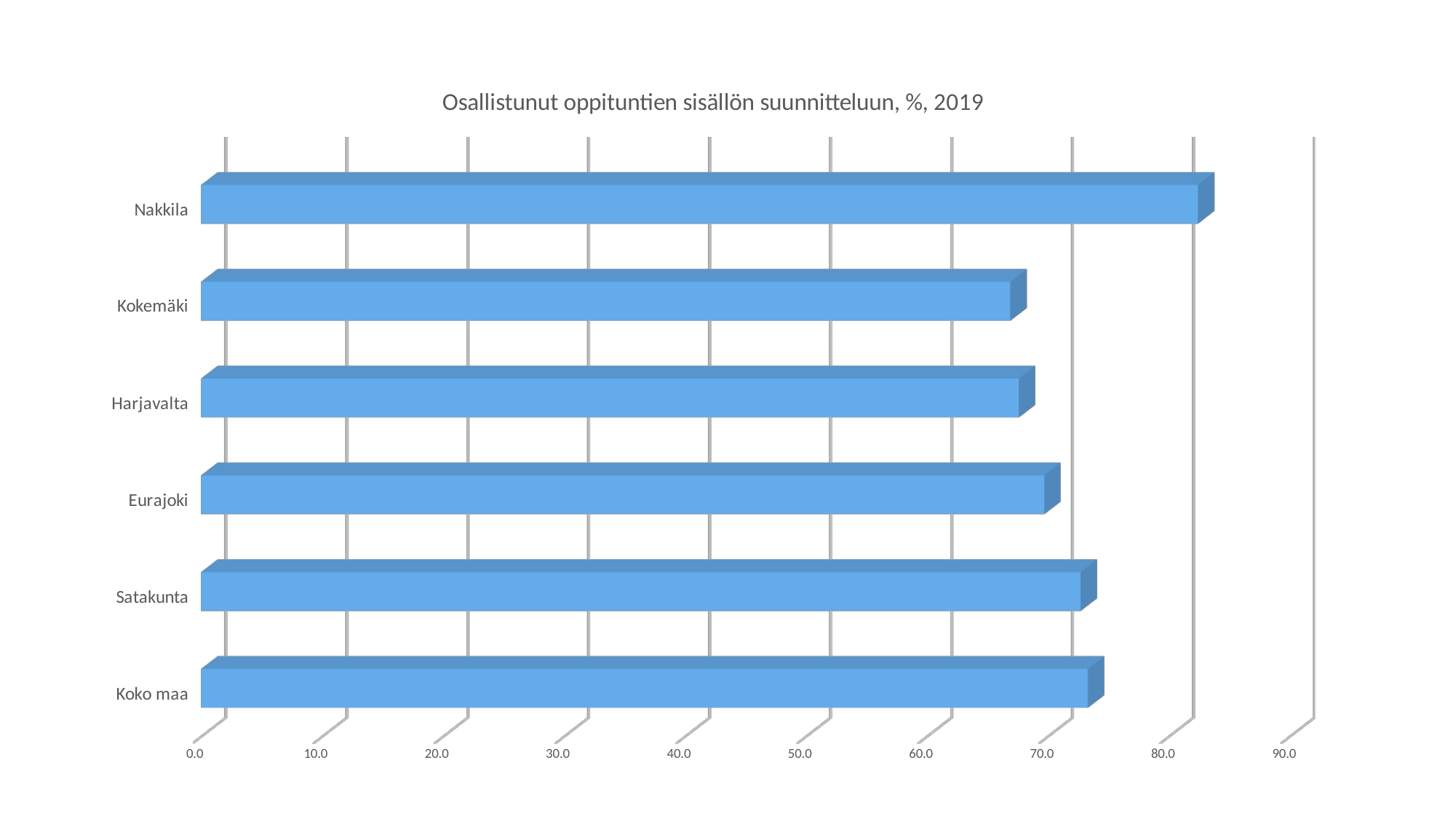
Which category has the highest value? Nakkila What is the title of the chart? Osallistunut oppituntien sisällön suunnitteluun, %, 2019 Is the value for Nakkila greater or less than 80.0? greater How many categories are shown in the chart? 6 Is the value for Harjavalta greater or less than 70.0? less Is the value for Kokemäki greater or less than 70.0? less What kind of chart is shown on the slide? bar chart Which is larger, the value for Nakkila or the value for Kokemäki? Nakkila What is the highest value shown on the horizontal axis? 90.0 Which is larger, the value for Koko maa or the value for Harjavalta? Koko maa